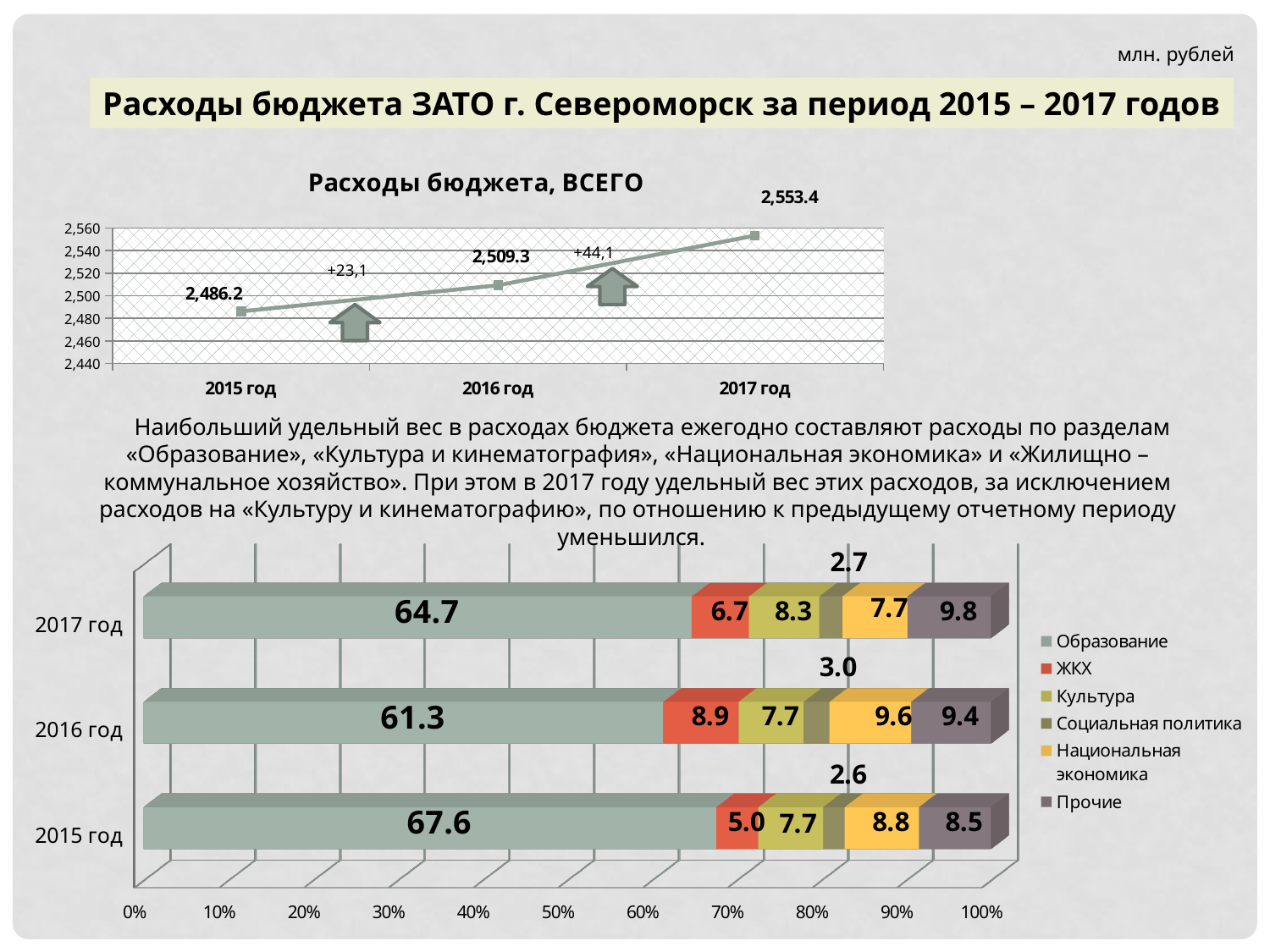
In the chart titled «Расходы бюджета, ВСЕГО», which year has the highest value? 2017 год How many years are shown in the stacked bar chart at the bottom of the slide? 3 In the stacked bar chart at the bottom of the slide, what is the difference between the values for Прочие in 2017 год and 2015 год? 1.3 In the chart titled «Расходы бюджета, ВСЕГО», what is the value for 2016 год? 2,509.3 What kind of chart is the chart titled «Расходы бюджета, ВСЕГО»? line chart In the stacked bar chart at the bottom of the slide, what is the value for Образование in 2016 год? 61.3 In the chart titled «Расходы бюджета, ВСЕГО», what is the difference between the values for 2017 год and 2015 год? 67.2 In the stacked bar chart at the bottom of the slide, is the value for Национальная экономика larger in 2016 год or in 2017 год? 2016 год In the chart titled «Расходы бюджета, ВСЕГО», do the values rise or fall from 2015 год to 2017 год? rise In the stacked bar chart at the bottom of the slide, which year has the lowest value for Образование? 2016 год How many series does the legend of the stacked bar chart at the bottom of the slide list? 6 In the stacked bar chart at the bottom of the slide, what is the value for ЖКХ in 2017 год? 6.7